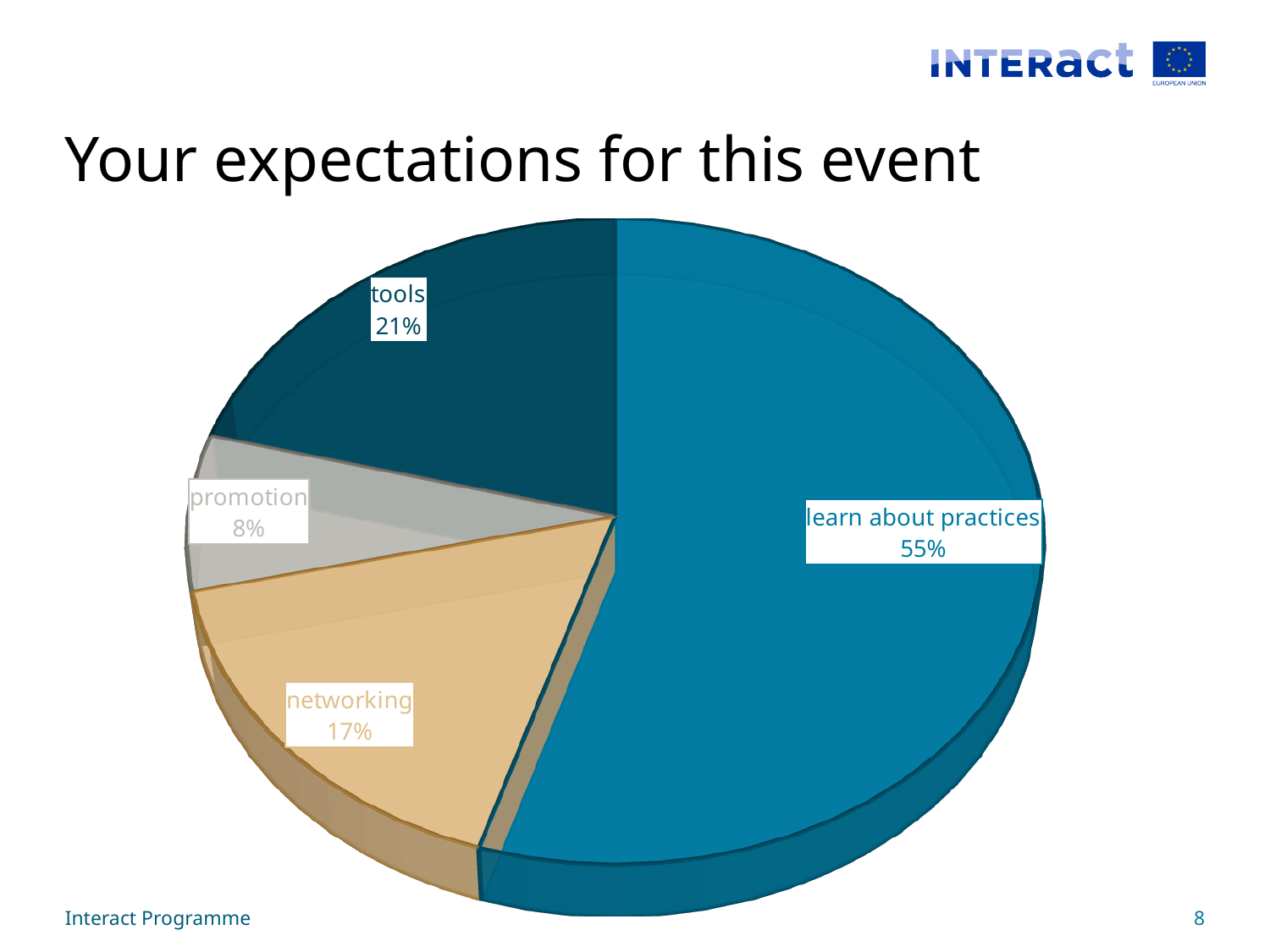
Which category has the largest slice of the pie? learn about practices What is the title of the slide containing the chart? Your expectations for this event Which category has the smallest slice of the pie? promotion What is the difference in percentage points between 'learn about practices' and 'promotion'? 47 What share of the pie does 'learn about practices' have? 55% How many categories are shown in the pie chart? 4 What percentage is shown for 'promotion'? 8% What is the difference in percentage points between 'tools' and 'networking'? 4 What percentage is shown for 'tools'? 21% Which is larger, the share for 'tools' or the share for 'networking'? tools What percentage is shown for 'networking'? 17% What kind of chart is shown on the slide? pie chart